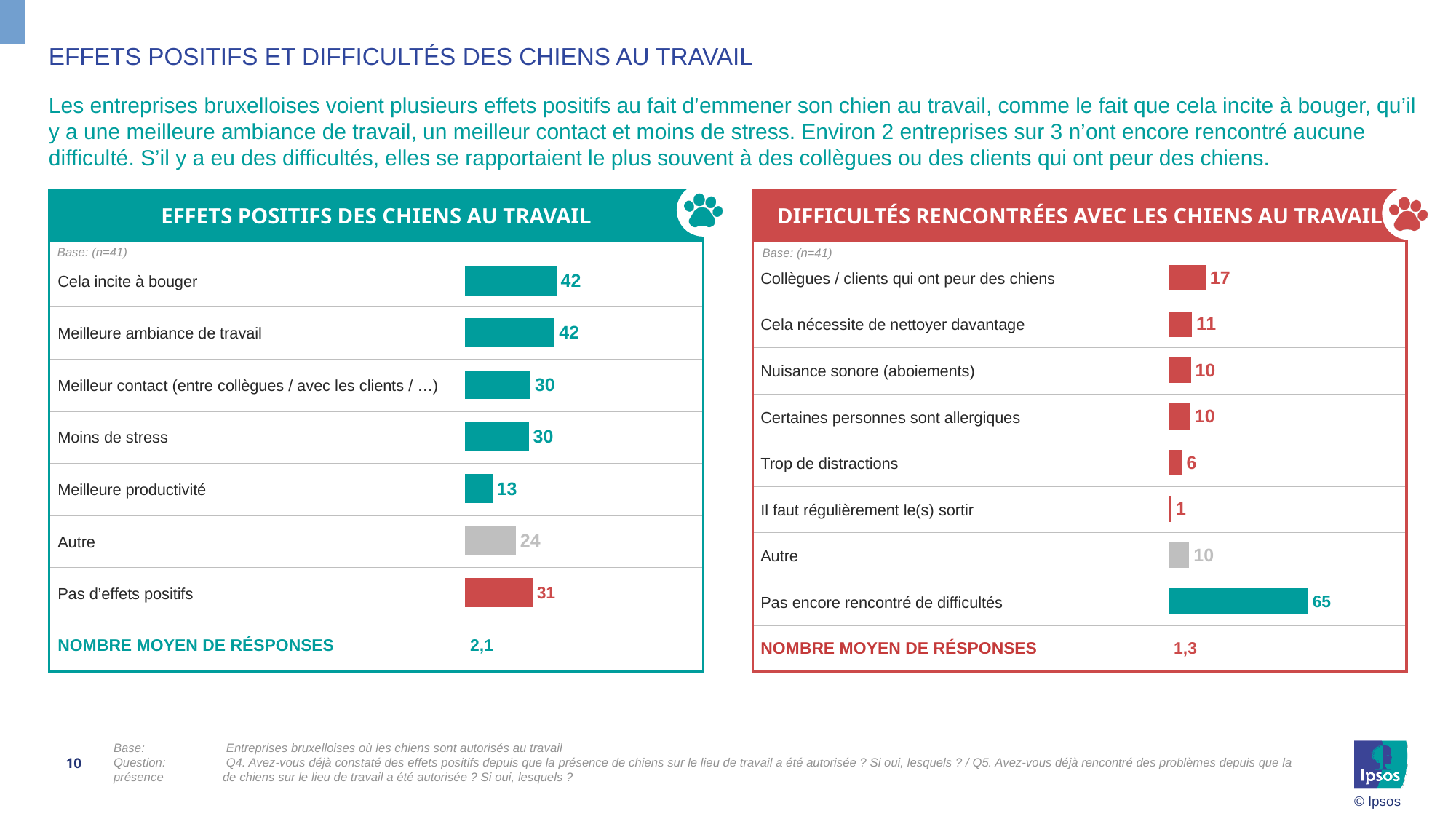
In the 'DIFFICULTÉS RENCONTRÉES AVEC LES CHIENS AU TRAVAIL' chart, what is the value for 'Pas encore rencontré de difficultés'? 65 In the 'DIFFICULTÉS RENCONTRÉES AVEC LES CHIENS AU TRAVAIL' chart, which category has the highest value? Pas encore rencontré de difficultés In the 'EFFETS POSITIFS DES CHIENS AU TRAVAIL' chart, what is the value for 'Meilleure productivité'? 13 In the 'DIFFICULTÉS RENCONTRÉES AVEC LES CHIENS AU TRAVAIL' chart, what is the difference between 'Collègues / clients qui ont peur des chiens' and 'Nuisance sonore (aboiements)'? 7 What kind of chart is used in the 'EFFETS POSITIFS DES CHIENS AU TRAVAIL' panel? Bar chart In the 'EFFETS POSITIFS DES CHIENS AU TRAVAIL' chart, how many categories are shown with bars? 7 In the 'EFFETS POSITIFS DES CHIENS AU TRAVAIL' chart, what is the difference between 'Cela incite à bouger' and 'Meilleure productivité'? 29 In the 'DIFFICULTÉS RENCONTRÉES AVEC LES CHIENS AU TRAVAIL' chart, which is larger: 'Cela nécessite de nettoyer davantage' or 'Trop de distractions'? Cela nécessite de nettoyer davantage In the 'DIFFICULTÉS RENCONTRÉES AVEC LES CHIENS AU TRAVAIL' chart, what is the value for 'Collègues / clients qui ont peur des chiens'? 17 In the 'DIFFICULTÉS RENCONTRÉES AVEC LES CHIENS AU TRAVAIL' chart, which category has the lowest value? Il faut régulièrement le(s) sortir In the 'EFFETS POSITIFS DES CHIENS AU TRAVAIL' chart, what is the value for 'Pas d'effets positifs'? 31 In the 'EFFETS POSITIFS DES CHIENS AU TRAVAIL' chart, what is the value for 'Moins de stress'? 30